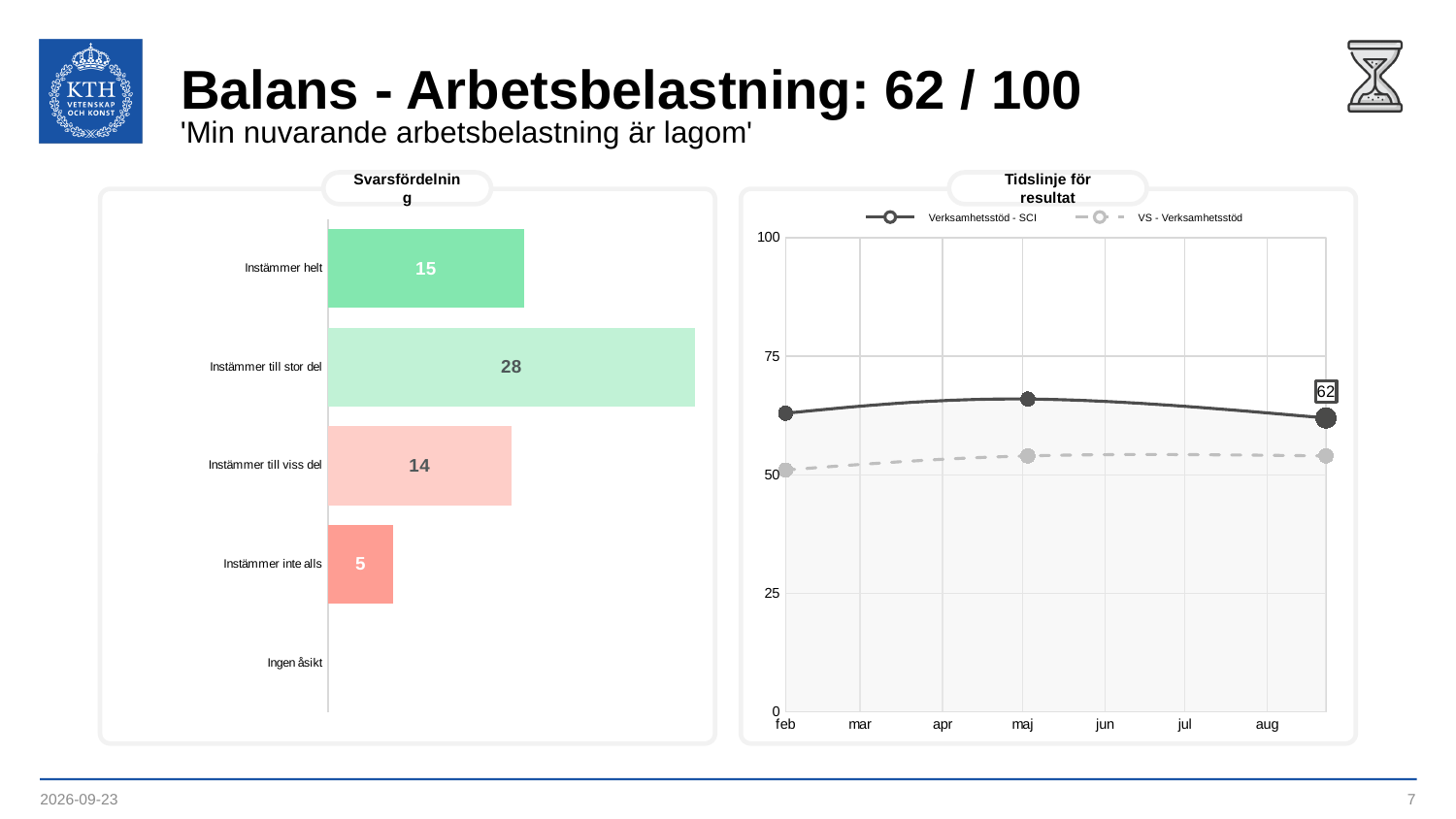
How many categories are listed on the axis of the Svarsfördelning chart? 5 In the Svarsfördelning chart, what is the value for 'Instämmer till stor del'? 28 What kind of chart is the Svarsfördelning chart? Bar chart In the Svarsfördelning chart, what is the difference between 'Instämmer till stor del' and 'Instämmer helt'? 13 In the Svarsfördelning chart, what is the value for 'Instämmer helt'? 15 In the Svarsfördelning chart, which category has the highest value? Instämmer till stor del In the 'Tidslinje för resultat' chart, is the value for Verksamhetsstöd - SCI in maj greater or less than 50? greater In the Svarsfördelning chart, which is larger: 'Instämmer helt' or 'Instämmer till viss del'? Instämmer helt In the 'Tidslinje för resultat' chart, is the value for VS - Verksamhetsstöd in feb greater or less than 75? less How many series does the legend of the 'Tidslinje för resultat' chart list? 2 In the Svarsfördelning chart, what is the value for 'Instämmer inte alls'? 5 In the 'Tidslinje för resultat' chart, what is the value shown by the data label on the last point of the Verksamhetsstöd - SCI series? 62